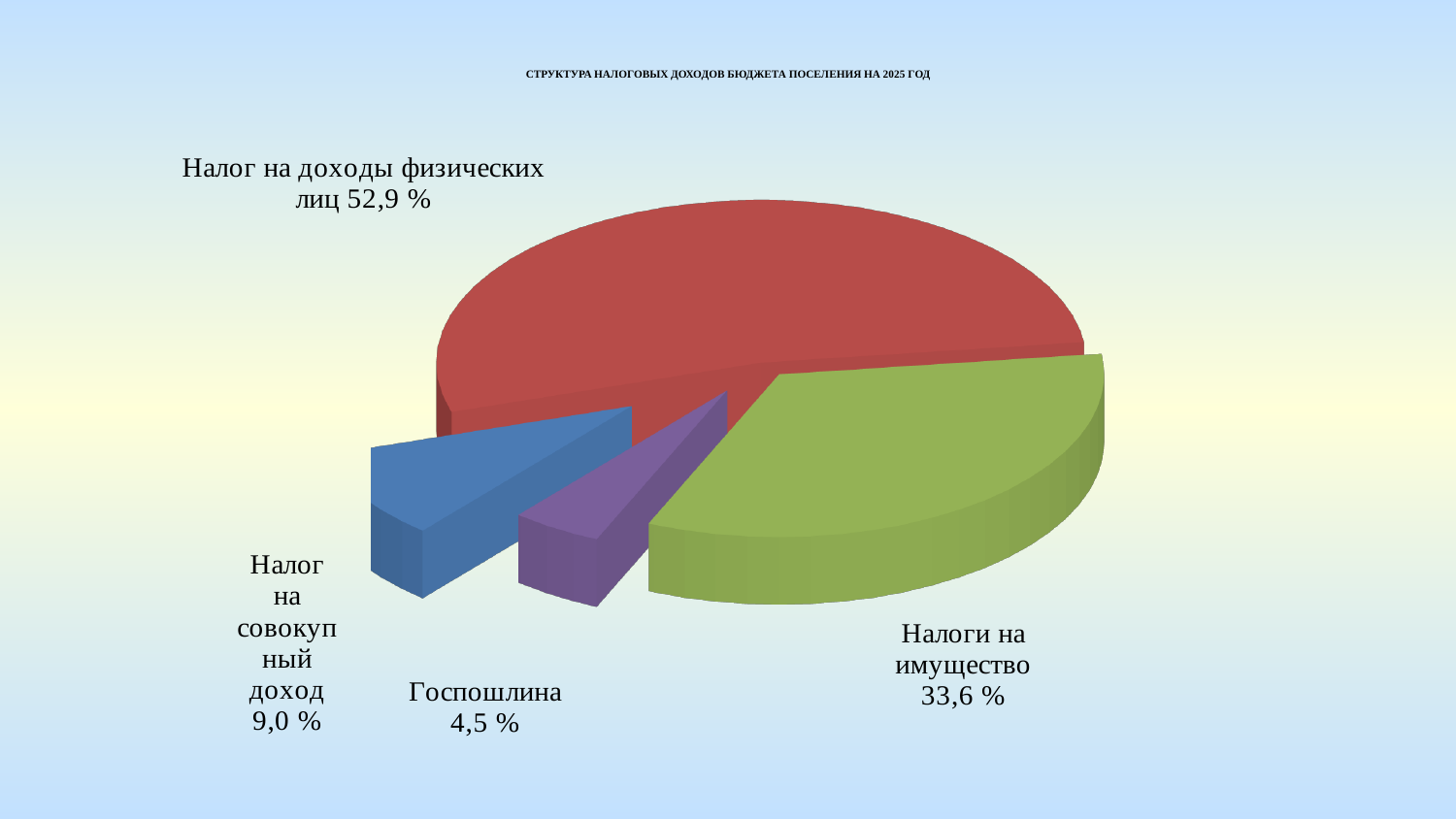
Как называется диаграмма на слайде? Структура налоговых доходов бюджета поселения на 2025 год Какова доля налога на совокупный доход? 9,0 % Какова доля госпошлины? 4,5 % Какой тип диаграммы показан на слайде? Круговая диаграмма Сколько секторов (категорий) показано на круговой диаграмме? 4 Что больше: доля налога на совокупный доход или доля госпошлины? Налог на совокупный доход Какова доля налогов на имущество? 33,6 % Какой вид налоговых доходов имеет наименьшую долю? Госпошлина Какой вид налоговых доходов имеет наибольшую долю? Налог на доходы физических лиц На сколько процентных пунктов доля налога на доходы физических лиц больше доли налогов на имущество? 19,3 Какова доля налога на доходы физических лиц в структуре налоговых доходов? 52,9 % Каким цветом показан сектор «Налоги на имущество»? Зелёным